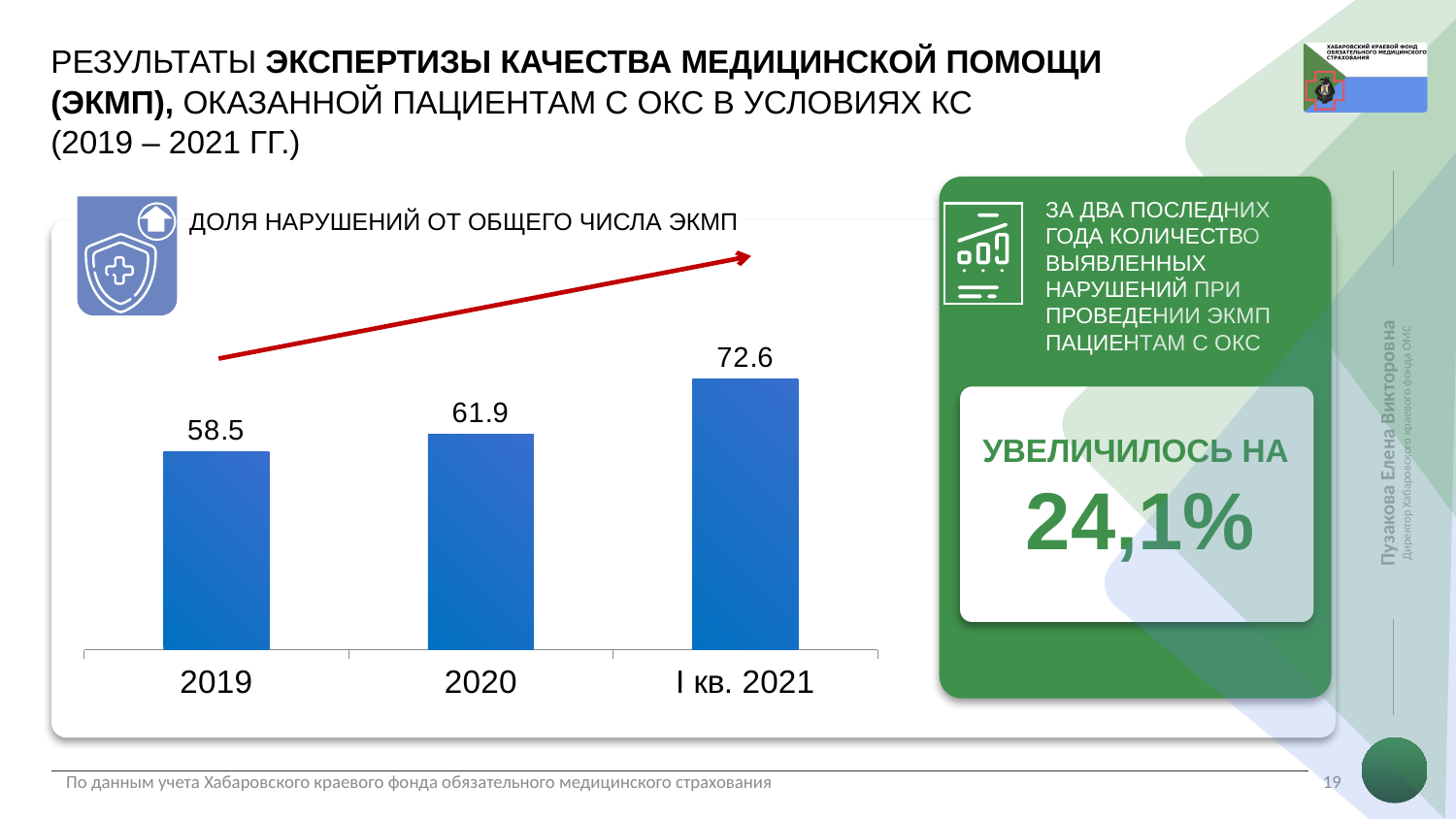
Which category has the lowest value in the chart? 2019 Do the values rise or fall from 2019 to I кв. 2021? Rise Which is larger, the value for 2020 or the value for I кв. 2021? I кв. 2021 What is the difference between the values for I кв. 2021 and 2020? 10.7 What is the value for 2019 in the chart? 58.5 What is the value for 2020 in the chart? 61.9 What kind of chart is shown on the slide? Bar chart What is the difference between the values for 2020 and 2019? 3.4 What is the difference between the values for I кв. 2021 and 2019? 14.1 How many categories are shown in the chart? 3 What is the value for I кв. 2021 in the chart? 72.6 Which category has the highest value in the chart? I кв. 2021